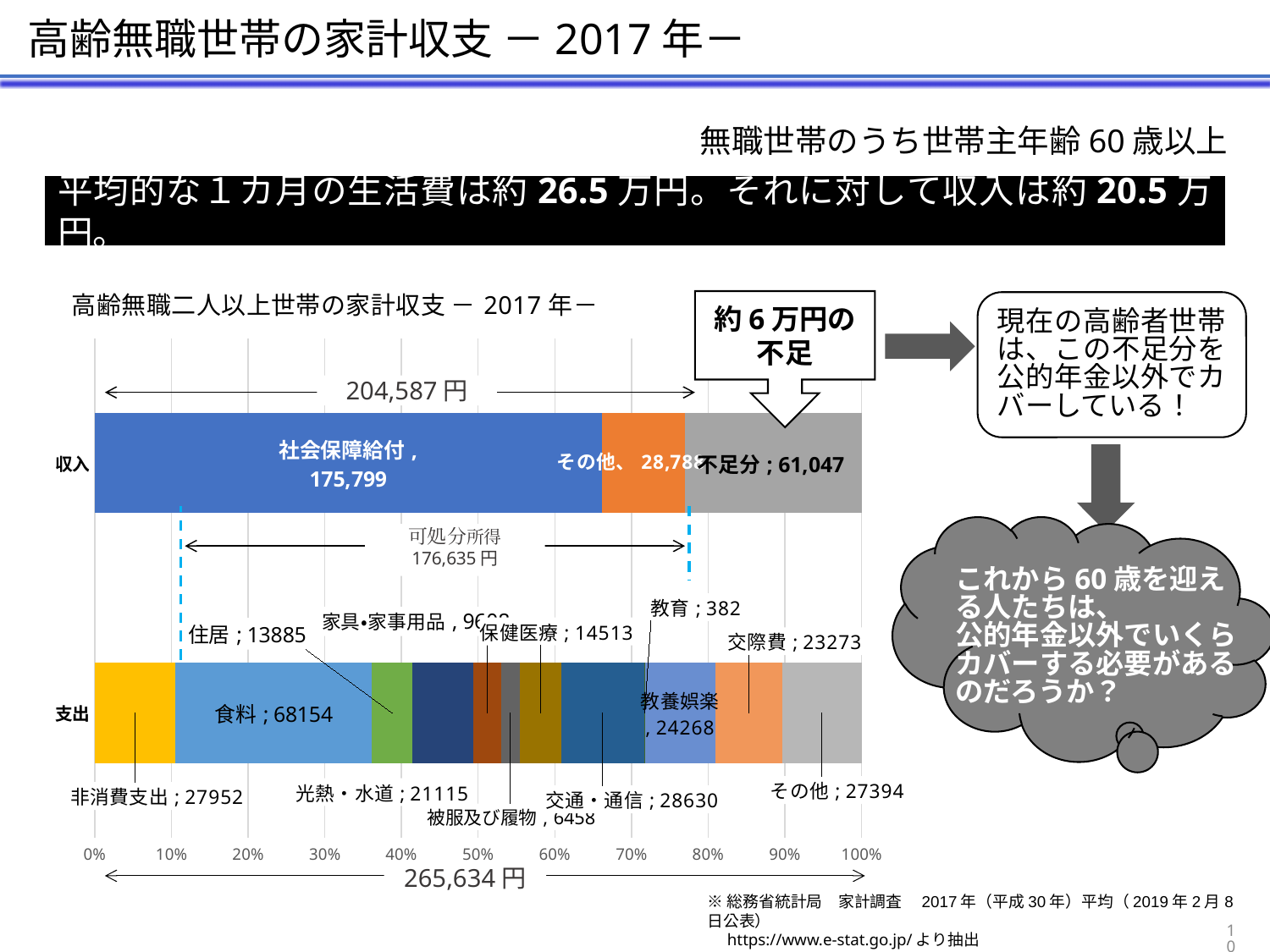
What is the value of 社会保障給付 in the 収入 bar? 175,799 What is the total of the 収入 bar (excluding 不足分) as printed on the slide? 204,587円 What is the value of 食料 in the 支出 bar? 68154 Which category in the 支出 bar has the smallest value? 教育 How many categories are labelled in the 支出 bar? 12 What is the total of the 支出 bar as printed on the slide? 265,634円 What is the value of 教育 in the 支出 bar? 382 What is the value of 不足分 in the 収入 bar? 61,047 What kind of chart is shown on the slide? Stacked bar chart What is the difference between 食料 and 住居 in the 支出 bar? 54269 Which category in the 支出 bar has the largest value? 食料 Which is larger in the 支出 bar, 交通・通信 or 交際費? 交通・通信